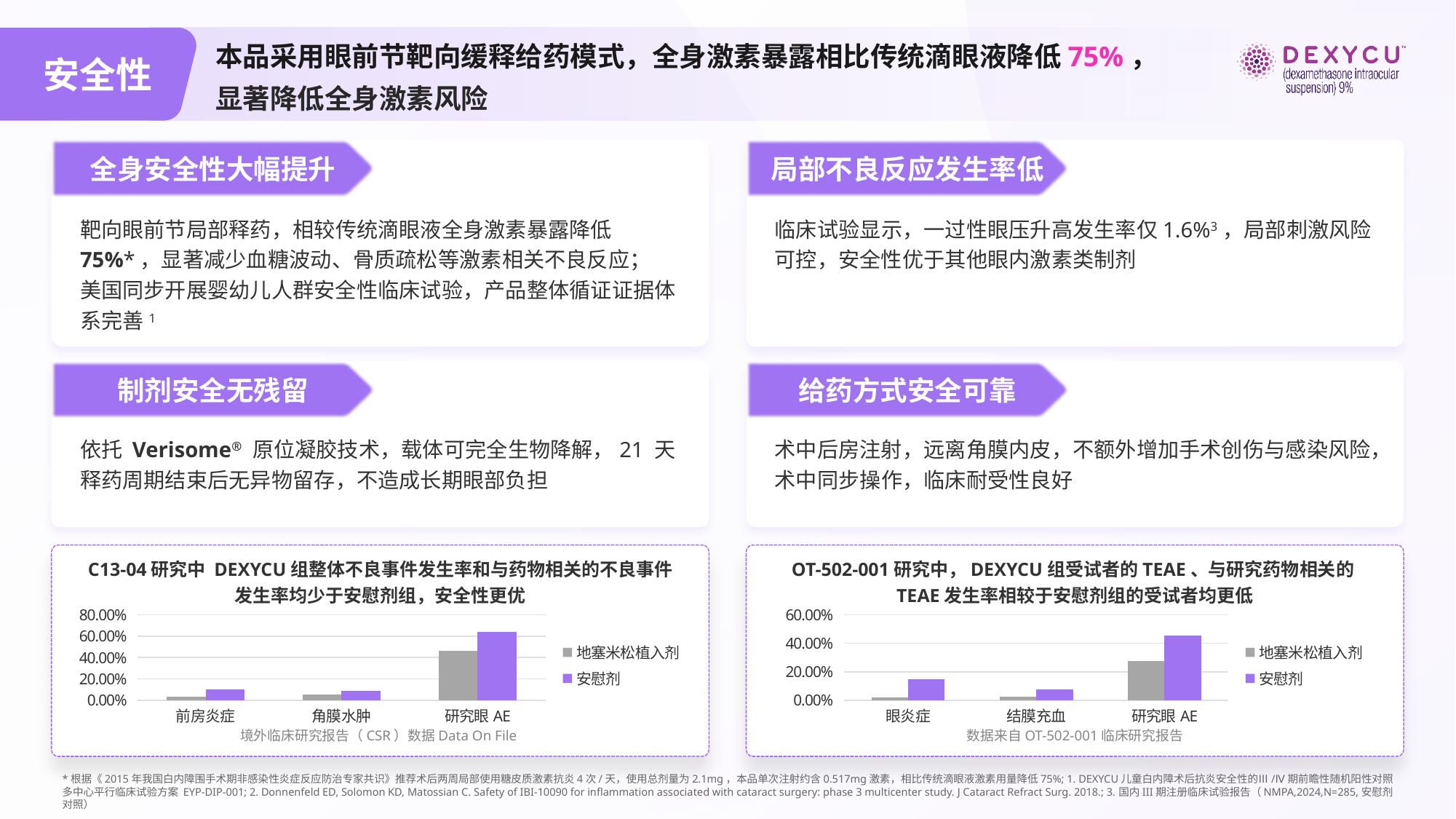
In the left chart (C13-04 研究), is the value for 地塞米松植入剂 in 研究眼 AE greater or less than 60.00%? less What kind of chart is the right chart (OT-502-001 研究)? bar chart In the left chart (C13-04 研究), how many series does the legend list? 2 In the right chart (OT-502-001 研究), for 眼炎症, which series has the larger value, 地塞米松植入剂 or 安慰剂? 安慰剂 In the right chart (OT-502-001 研究), which category has the highest value for 安慰剂? 研究眼 AE In the right chart (OT-502-001 研究), is the value for 地塞米松植入剂 in 研究眼 AE greater or less than 40.00%? less In the right chart (OT-502-001 研究), what colour represents the 安慰剂 series? purple In the left chart (C13-04 研究), for 前房炎症, which series has the larger value, 地塞米松植入剂 or 安慰剂? 安慰剂 In the left chart (C13-04 研究), which category has the highest value for 安慰剂? 研究眼 AE In the left chart (C13-04 研究), how many categories are shown on the x axis? 3 In the left chart (C13-04 研究), is the value for 安慰剂 in 研究眼 AE greater or less than 40.00%? greater What kind of chart is the left chart (C13-04 研究)? bar chart